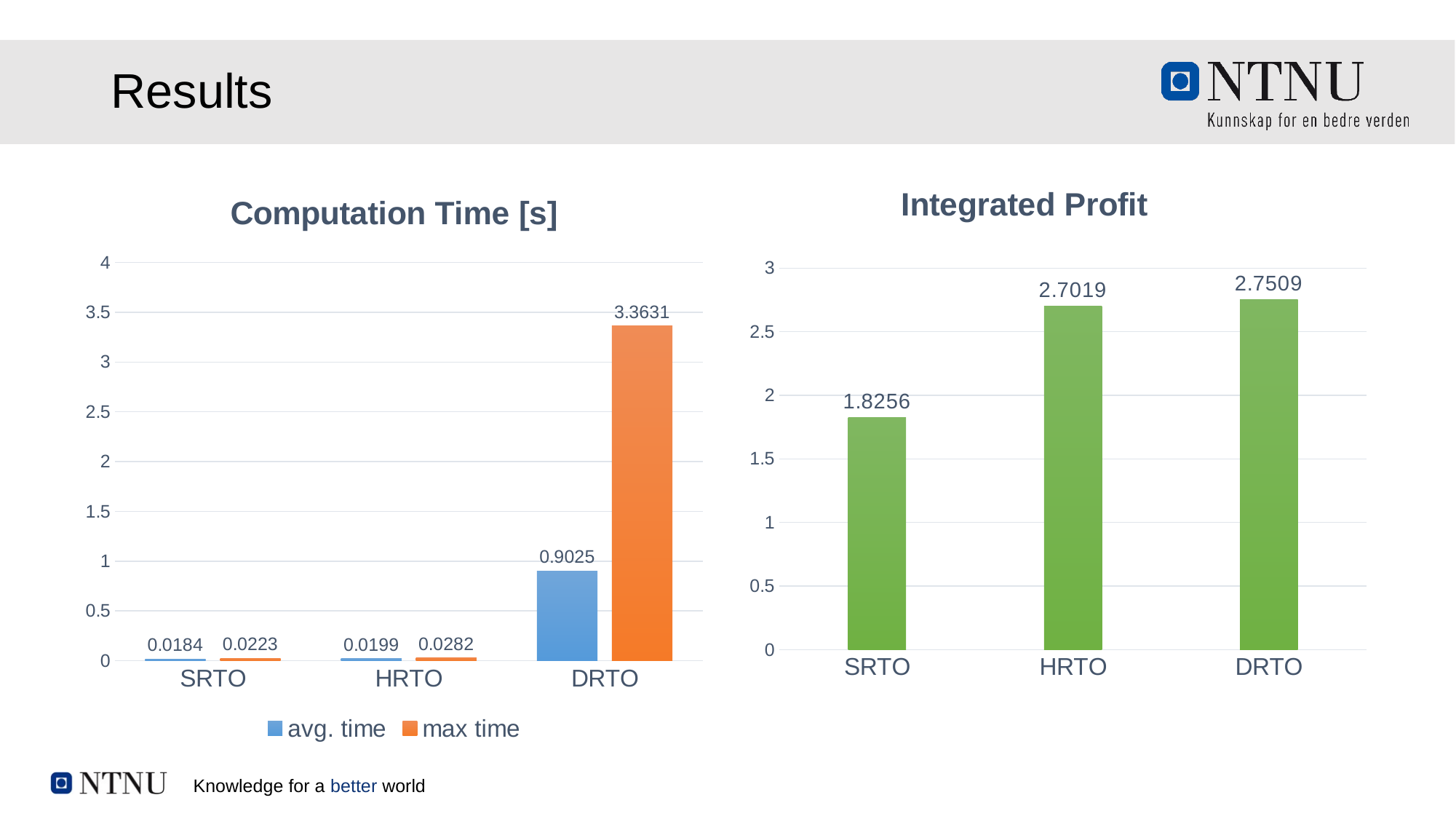
How many series does the legend of the Computation Time [s] chart list? 2 How many categories are shown in the Integrated Profit chart? 3 In the Computation Time [s] chart, which category has the highest avg. time? DRTO In the Integrated Profit chart, which category has the lowest value? SRTO In the Integrated Profit chart, which category has the highest value? DRTO What kind of chart is the Integrated Profit chart? bar chart In the Computation Time [s] chart, what is the difference between the max time and avg. time for DRTO? 2.4606 In the Computation Time [s] chart, what is the avg. time for HRTO? 0.0199 In the Integrated Profit chart, what is the difference between HRTO and SRTO? 0.8763 In the Computation Time [s] chart, is the max time for SRTO larger or smaller than the max time for HRTO? smaller In the Computation Time [s] chart, what is the max time for DRTO? 3.3631 In the Integrated Profit chart, what is the value for SRTO? 1.8256